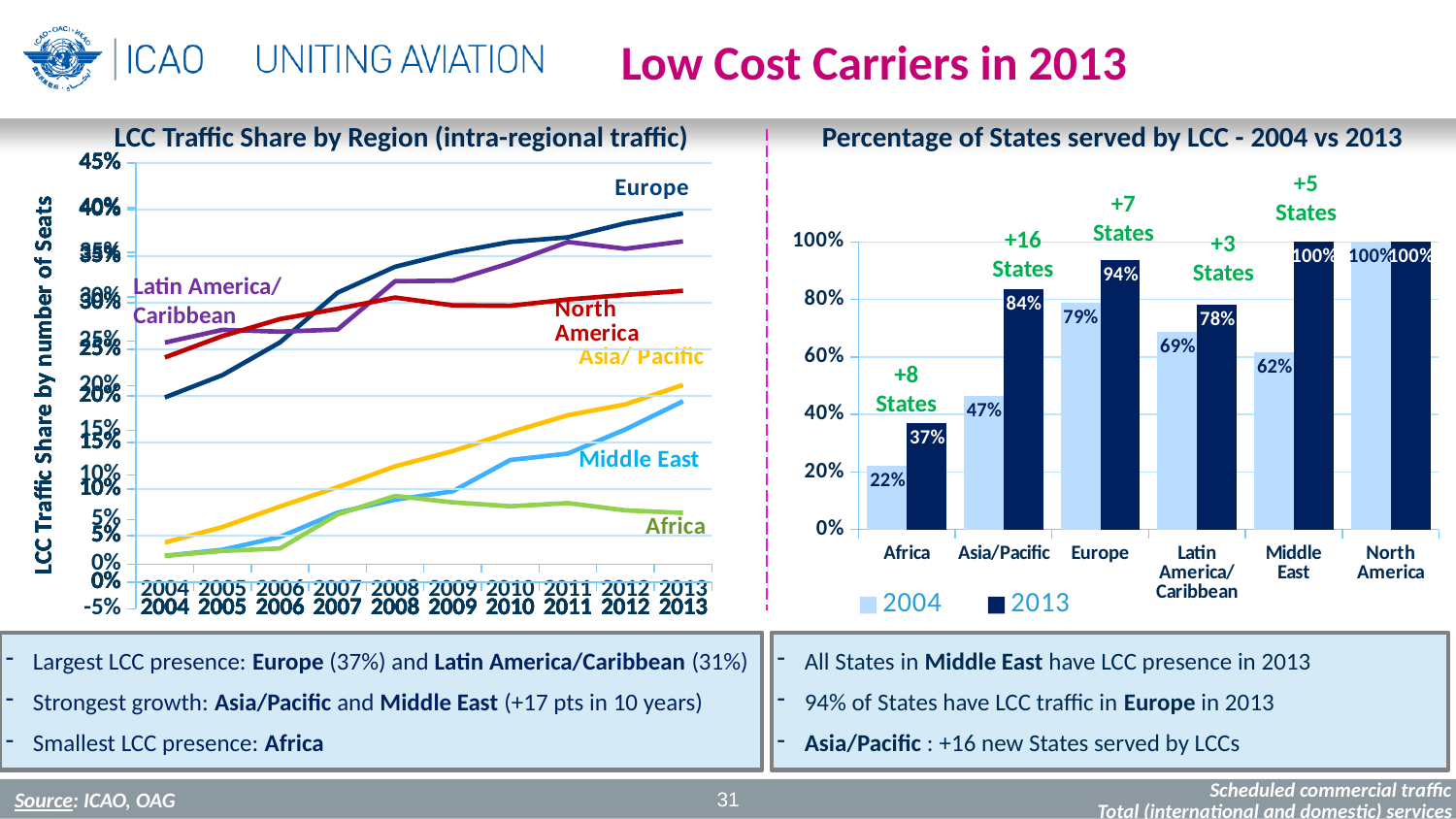
In the 'LCC Traffic Share by Region (intra-regional traffic)' chart, does the Middle East line rise or fall from 2004 to 2013? rise What kind of chart is the 'LCC Traffic Share by Region (intra-regional traffic)' chart? line chart In the 'LCC Traffic Share by Region (intra-regional traffic)' chart, is the value for Europe in 2013 greater or less than 35%? greater In the 'Percentage of States served by LCC - 2004 vs 2013' chart, what is the value for Asia/Pacific in 2004? 47% How many regions are shown on the x axis of the 'Percentage of States served by LCC - 2004 vs 2013' chart? 6 How many series does the legend of the 'Percentage of States served by LCC - 2004 vs 2013' chart list? 2 In the 'Percentage of States served by LCC - 2004 vs 2013' chart, which is larger: the 2004 value for Europe or the 2004 value for Latin America/Caribbean? Europe In the 'Percentage of States served by LCC - 2004 vs 2013' chart, what is the value for Africa in 2013? 37% What kind of chart is the 'Percentage of States served by LCC - 2004 vs 2013' chart? bar chart In the 'Percentage of States served by LCC - 2004 vs 2013' chart, what is the difference between the 2013 and 2004 values for Middle East? 38% In the 'Percentage of States served by LCC - 2004 vs 2013' chart, what is the value for Europe in 2013? 94% In the 'Percentage of States served by LCC - 2004 vs 2013' chart, which region has the lowest value in 2004? Africa